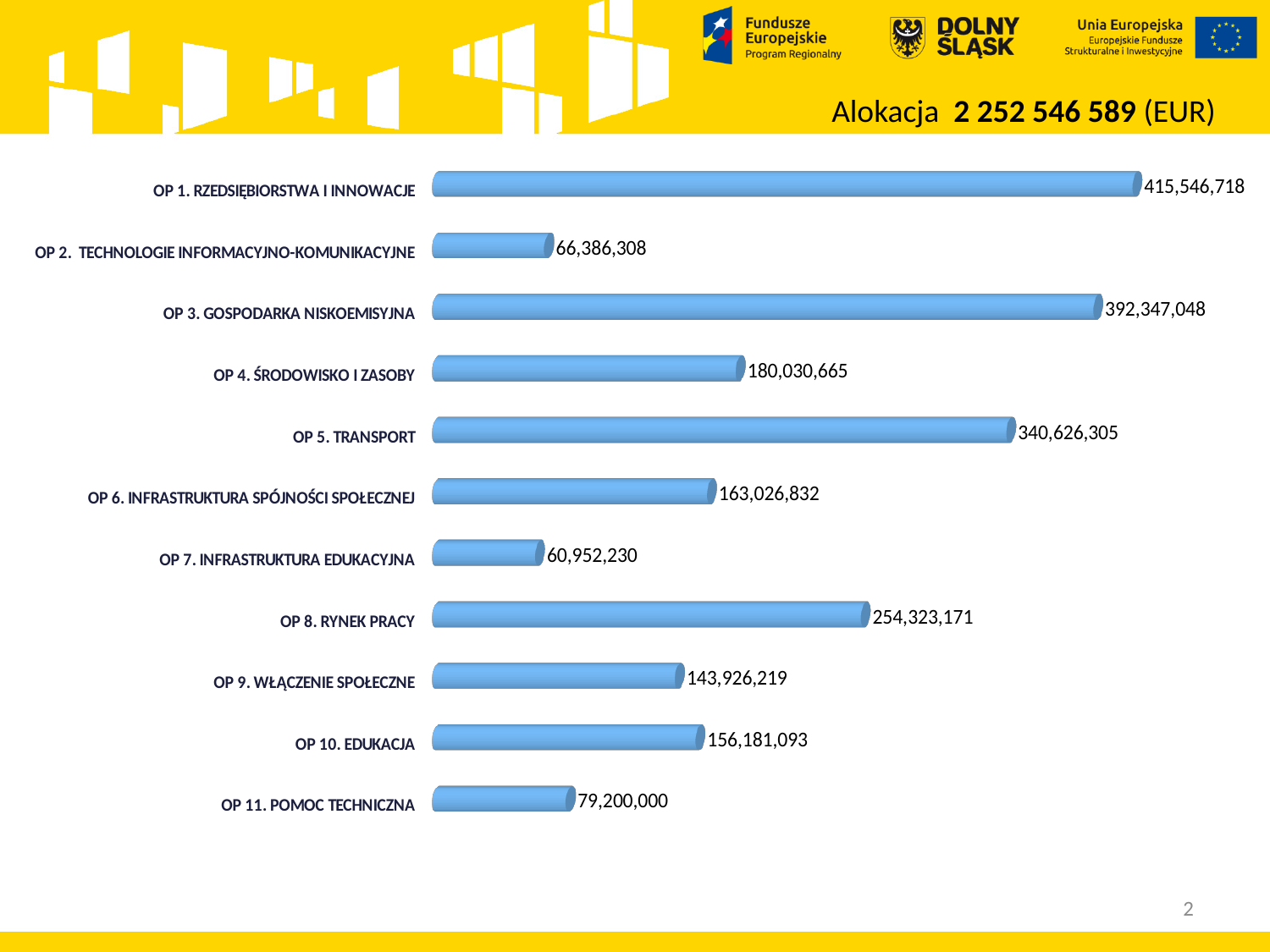
What is the value for OP 8. RYNEK PRACY? 254,323,171 How many categories are shown in the chart? 11 Which category has the lowest value? OP 7. INFRASTRUKTURA EDUKACYJNA What is the value for OP 2. TECHNOLOGIE INFORMACYJNO-KOMUNIKACYJNE? 66,386,308 What is the difference between the values for OP 4. ŚRODOWISKO I ZASOBY and OP 6. INFRASTRUKTURA SPÓJNOŚCI SPOŁECZNEJ? 17,003,833 Which category has the highest value? OP 1. RZEDSIĘBIORSTWA I INNOWACJE Which is larger, the value for OP 9. WŁĄCZENIE SPOŁECZNE or OP 10. EDUKACJA? OP 10. EDUKACJA Which is larger, the value for OP 5. TRANSPORT or OP 8. RYNEK PRACY? OP 5. TRANSPORT What is the value for OP 11. POMOC TECHNICZNA? 79,200,000 What is the difference between the values for OP 1. RZEDSIĘBIORSTWA I INNOWACJE and OP 3. GOSPODARKA NISKOEMISYJNA? 23,199,670 What kind of chart is shown on the slide? Bar chart What is the value for OP 5. TRANSPORT? 340,626,305